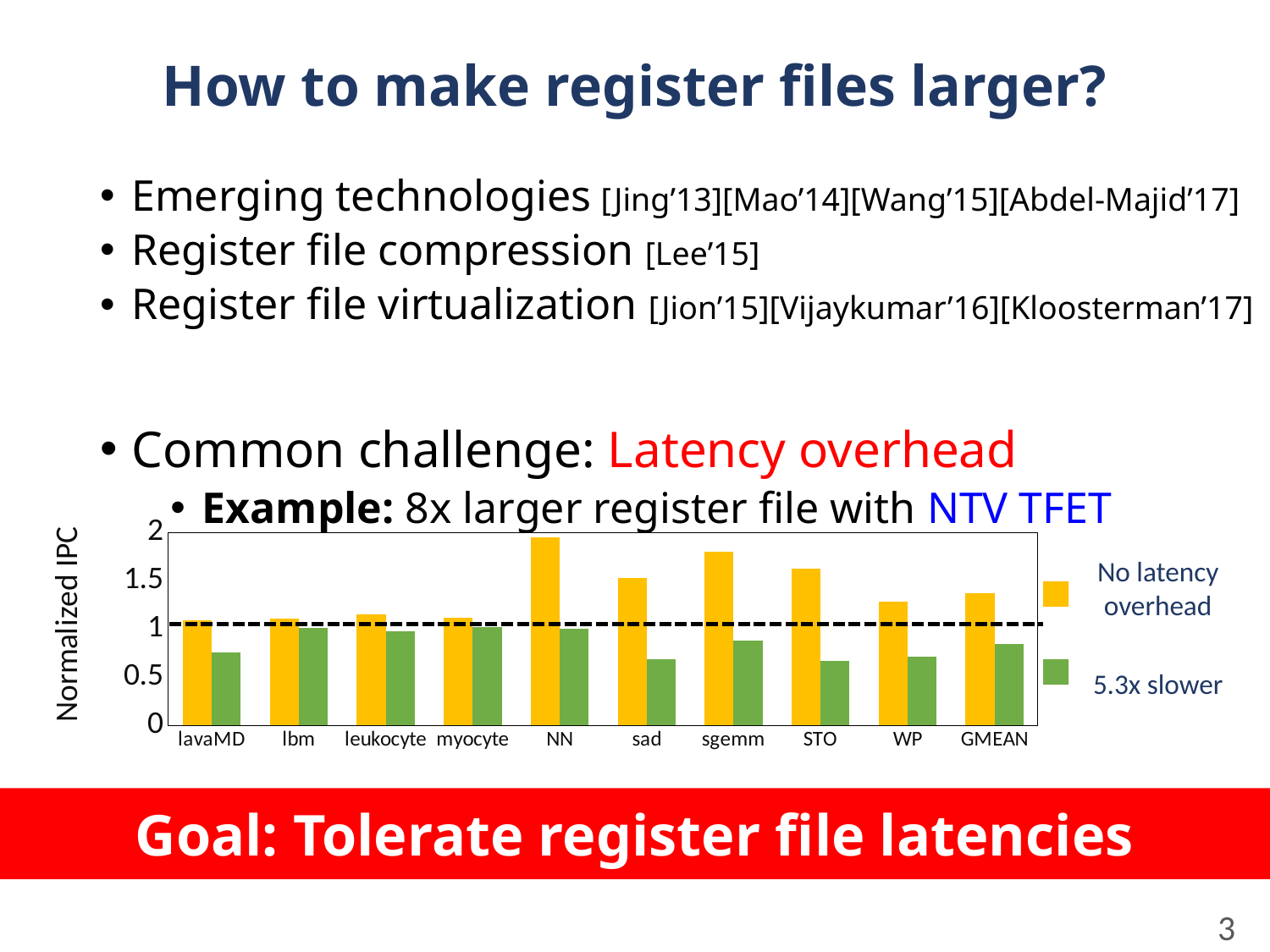
Is the 'No latency overhead' value for sgemm greater or less than 1.5? greater How many series does the chart's legend list? 2 Is the 'No latency overhead' value for GMEAN greater or less than 1.5? less Is the '5.3x slower' value for lavaMD greater or less than 0.5? greater Which benchmark has the highest 'No latency overhead' value in the chart? NN Which is larger: the '5.3x slower' value for lavaMD or for lbm? lbm What kind of chart is shown on the slide? bar chart Which series in the chart is drawn in green? 5.3x slower How many benchmark categories are shown on the x axis of the chart? 10 What is the label of the y axis of the chart? Normalized IPC